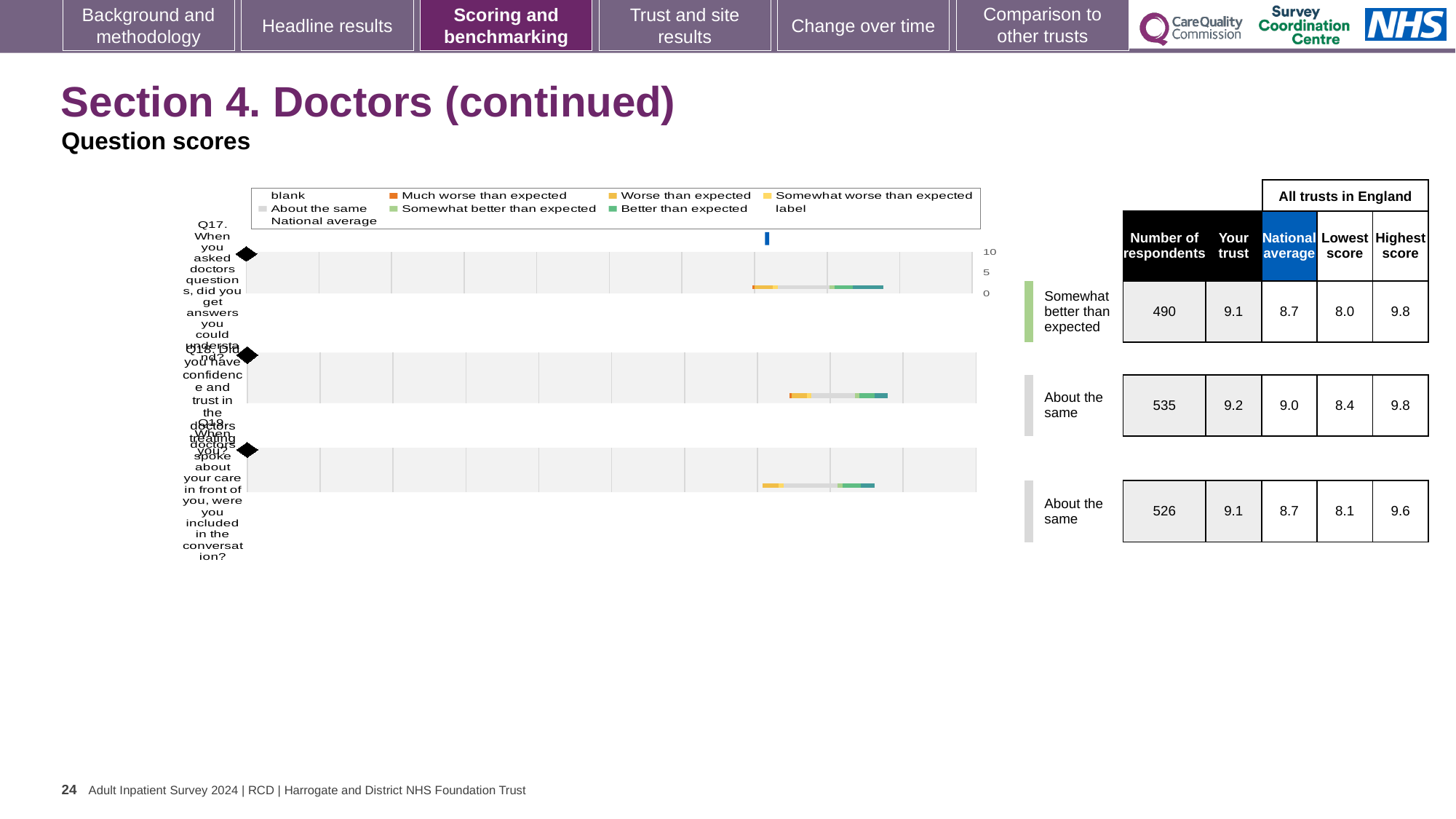
Which legend entry is shown in light green in the chart's legend? Somewhat better than expected What is the highest tick value shown on the chart's axis? 10 How many entries does the chart's legend list? 9 How many question categories (rows) does the chart show? 3 Which legend entry is shown in orange in the chart's legend? Much worse than expected What kind of chart is shown on the slide? bar chart